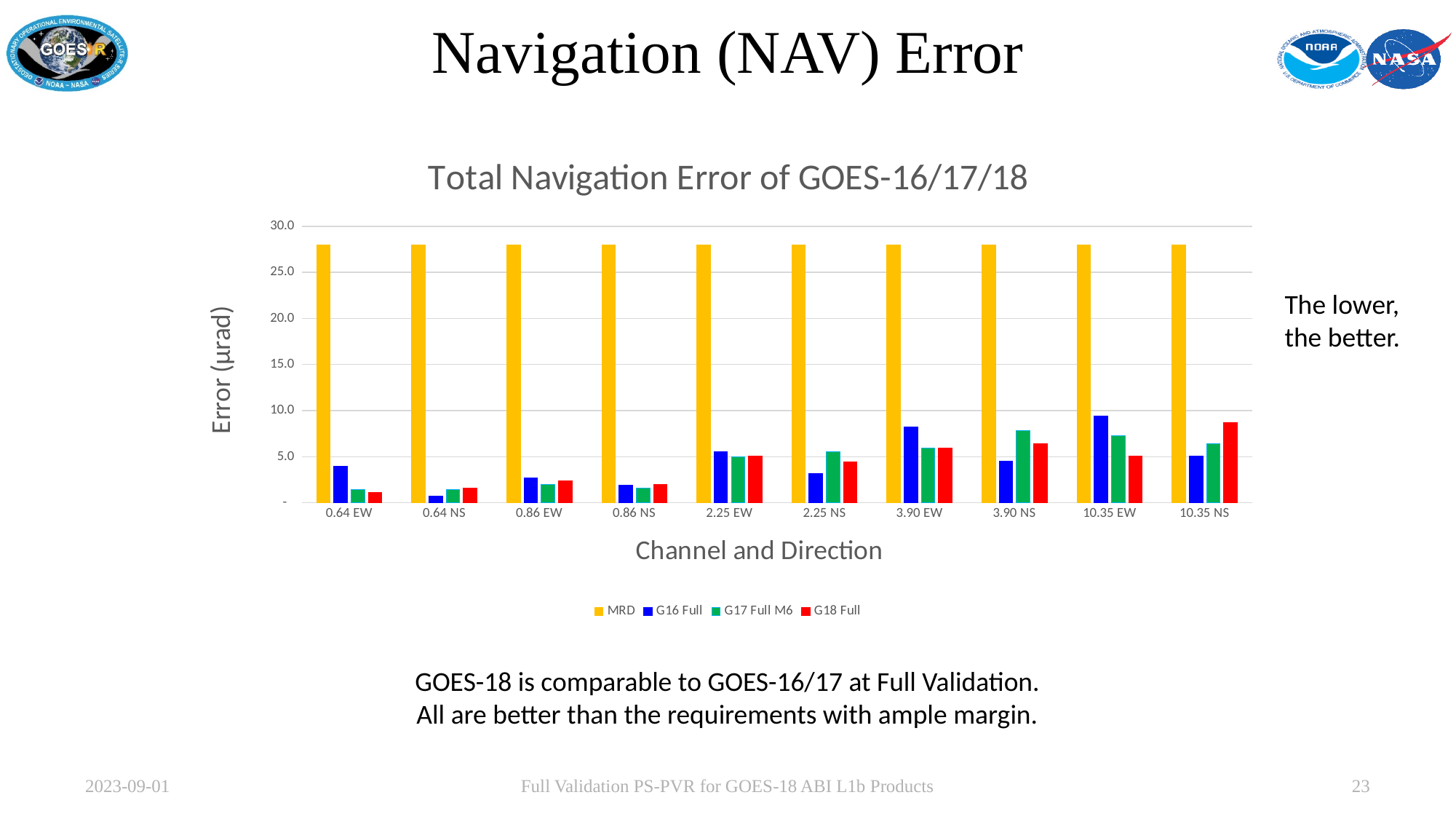
What kind of chart is shown on the slide? bar chart Which is larger at 10.35 EW, the G16 Full value or the G18 Full value? G16 Full How many channel-and-direction categories are shown on the x axis? 10 Is the MRD value for 0.64 EW greater or less than 25? greater What is the label of the y axis? Error (μrad) Is the G16 Full value for 0.64 NS greater or less than 5? less Is the G18 Full value for 10.35 NS greater or less than 5? greater What is the title of the chart? Total Navigation Error of GOES-16/17/18 How many series does the chart legend list? 4 Which is larger at 10.35 NS, the G16 Full value or the G18 Full value? G18 Full For which channel and direction is the G16 Full value highest? 10.35 EW